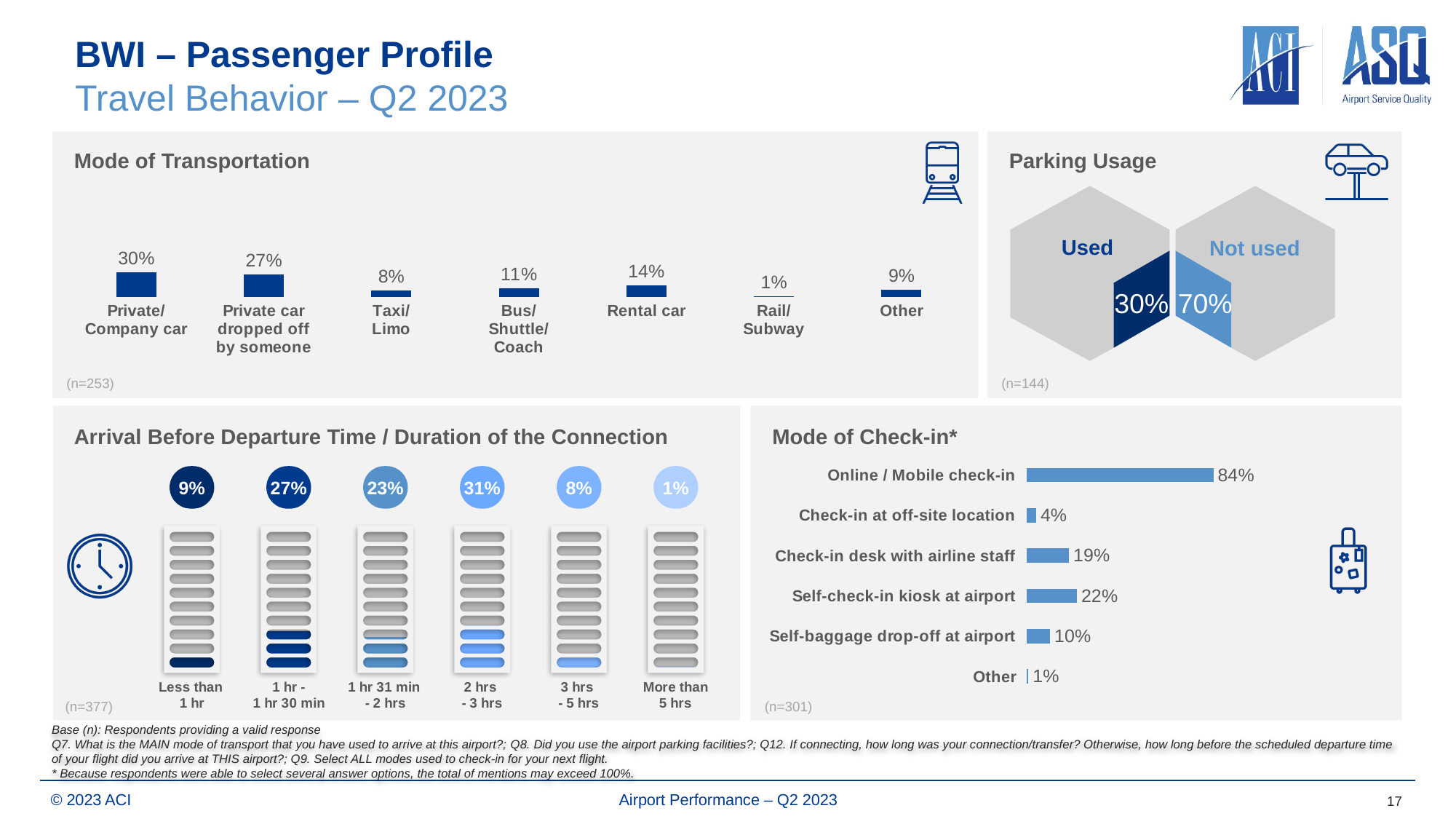
In the Mode of Transportation chart, which mode has the highest percentage? Private/Company car In the Parking Usage chart, which is larger, Used or Not used? Not used In the Arrival Before Departure Time / Duration of the Connection chart, what percentage arrived 2 hrs - 3 hrs before departure? 31% In the Mode of Transportation chart, how many transportation modes are shown? 7 What kind of chart is the Mode of Check-in chart? Bar chart In the Mode of Transportation chart, what percentage of passengers used a Rental car? 14% In the Mode of Transportation chart, what is the difference between Private/Company car and Private car dropped off by someone? 3% In the Mode of Transportation chart, which mode has the lowest percentage? Rail/Subway In the Mode of Check-in chart, what percentage used Online / Mobile check-in? 84% In the Parking Usage chart, what percentage of passengers used the airport parking facilities? 30% In the Arrival Before Departure Time / Duration of the Connection chart, which time category has the highest percentage? 2 hrs - 3 hrs In the Mode of Check-in chart, what is the difference between Self-check-in kiosk at airport and Check-in desk with airline staff? 3%